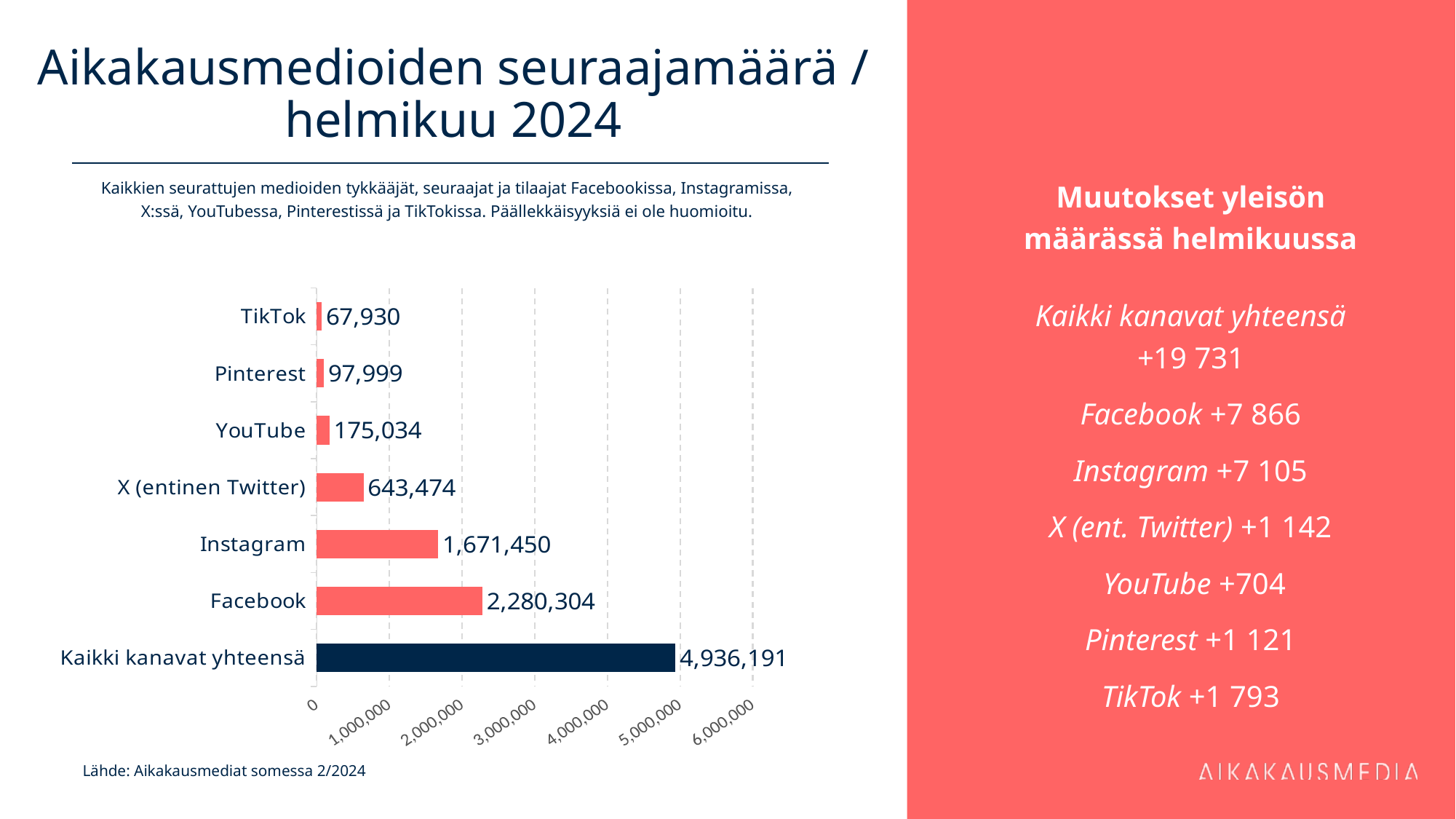
Is the value for X (entinen Twitter) greater or less than 1,000,000? less Which category has the lowest value in the chart? TikTok What is the value shown for X (entinen Twitter)? 643,474 What is the difference between the values for Pinterest and TikTok? 30,069 What kind of chart is shown on the slide? bar chart What is the difference between the values for Facebook and Instagram? 608,854 Which category has the highest value in the chart? Kaikki kanavat yhteensä What is the value shown for Instagram? 1,671,450 Which has a larger value, YouTube or Pinterest? YouTube How many categories are shown in the chart? 7 What is the value shown for Kaikki kanavat yhteensä? 4,936,191 What is the value shown for Facebook? 2,280,304